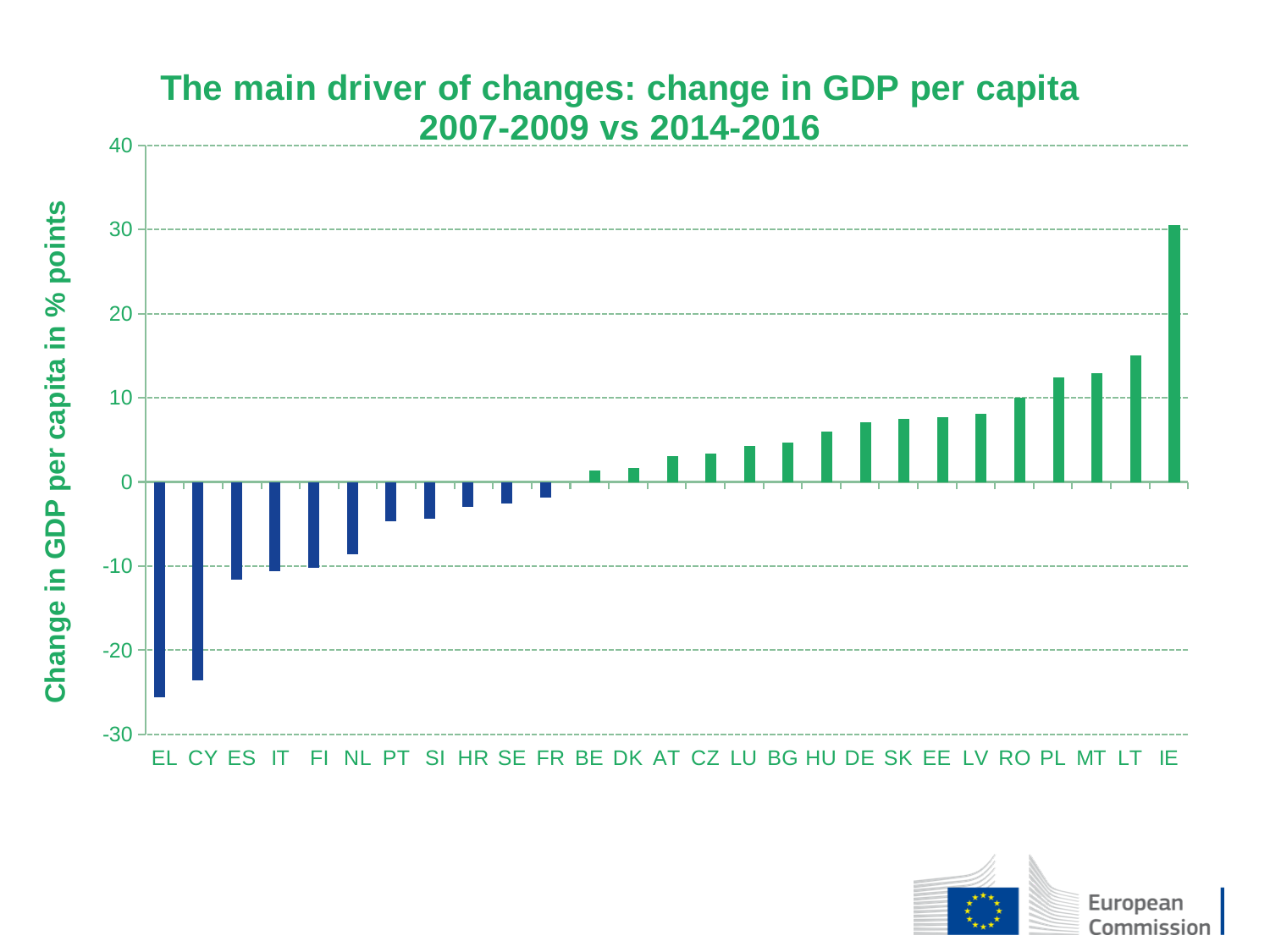
Which country has the lowest change in GDP per capita? EL Which country has the highest change in GDP per capita? IE Which has the larger value, IE or LT? IE Do the values rise or fall moving from left to right along the x axis? rise How many countries are shown on the x axis? 27 Is the value for IE greater or less than 20? greater What colour are the bars with negative values? blue Is the value for CY greater or less than -20? less Is the value for EL greater or less than -20? less What kind of chart is shown on the slide? bar chart